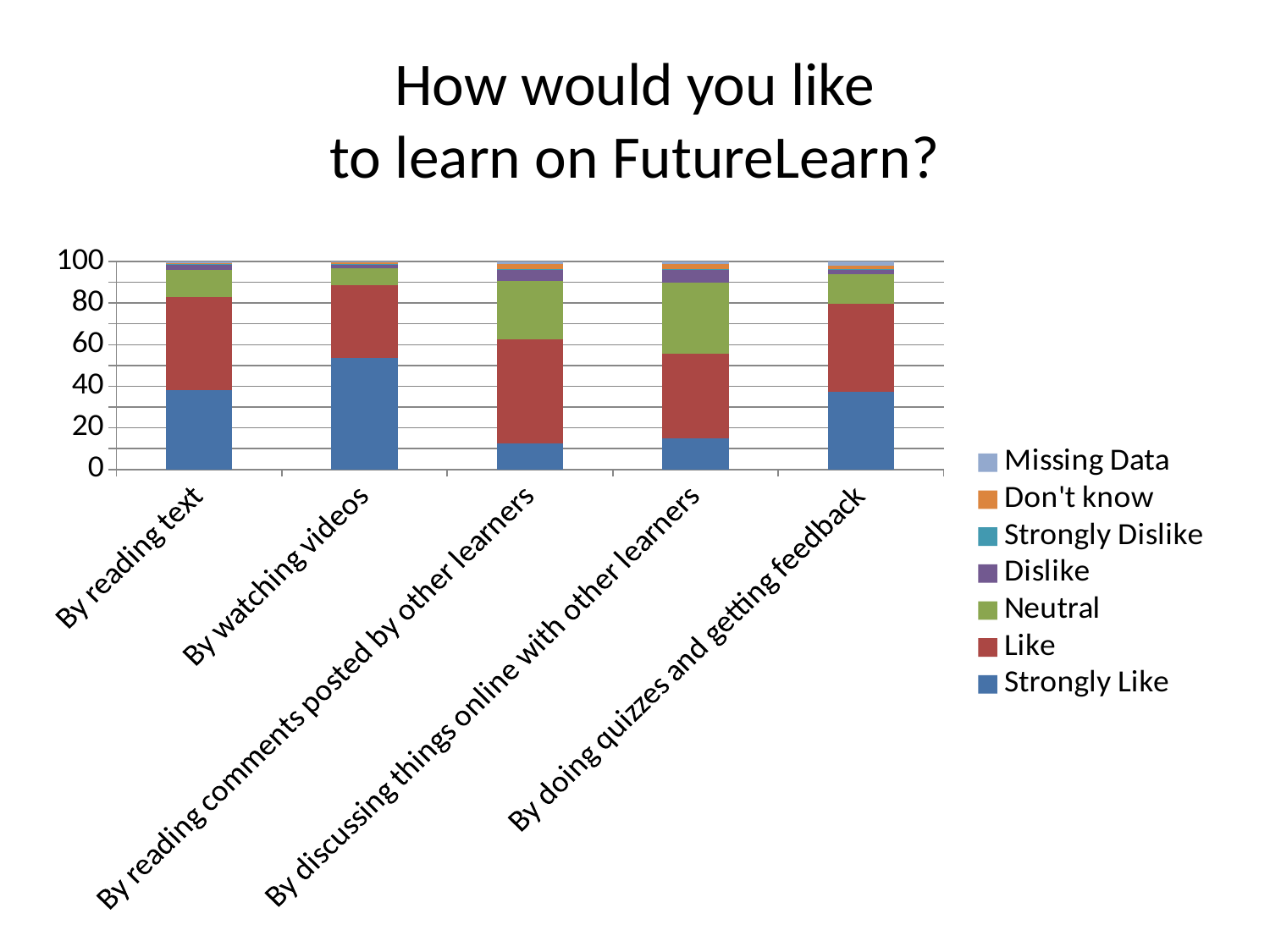
How many categories are shown on the x axis? 5 Which category has the largest Strongly Like segment? By watching videos Which has a larger Neutral segment: By watching videos or By discussing things online with other learners? By discussing things online with other learners Is the Strongly Like value for By doing quizzes and getting feedback greater or less than 20? greater Is the Strongly Like value for By reading comments posted by other learners greater or less than 20? less Which series is shown in red? Like What is the title of the chart? How would you like to learn on FutureLearn? What kind of chart is shown on the slide? Stacked bar chart Is the Strongly Like value for By watching videos greater or less than 40? greater Which has a larger Strongly Like segment: By watching videos or By reading comments posted by other learners? By watching videos How many series does the legend list? 7